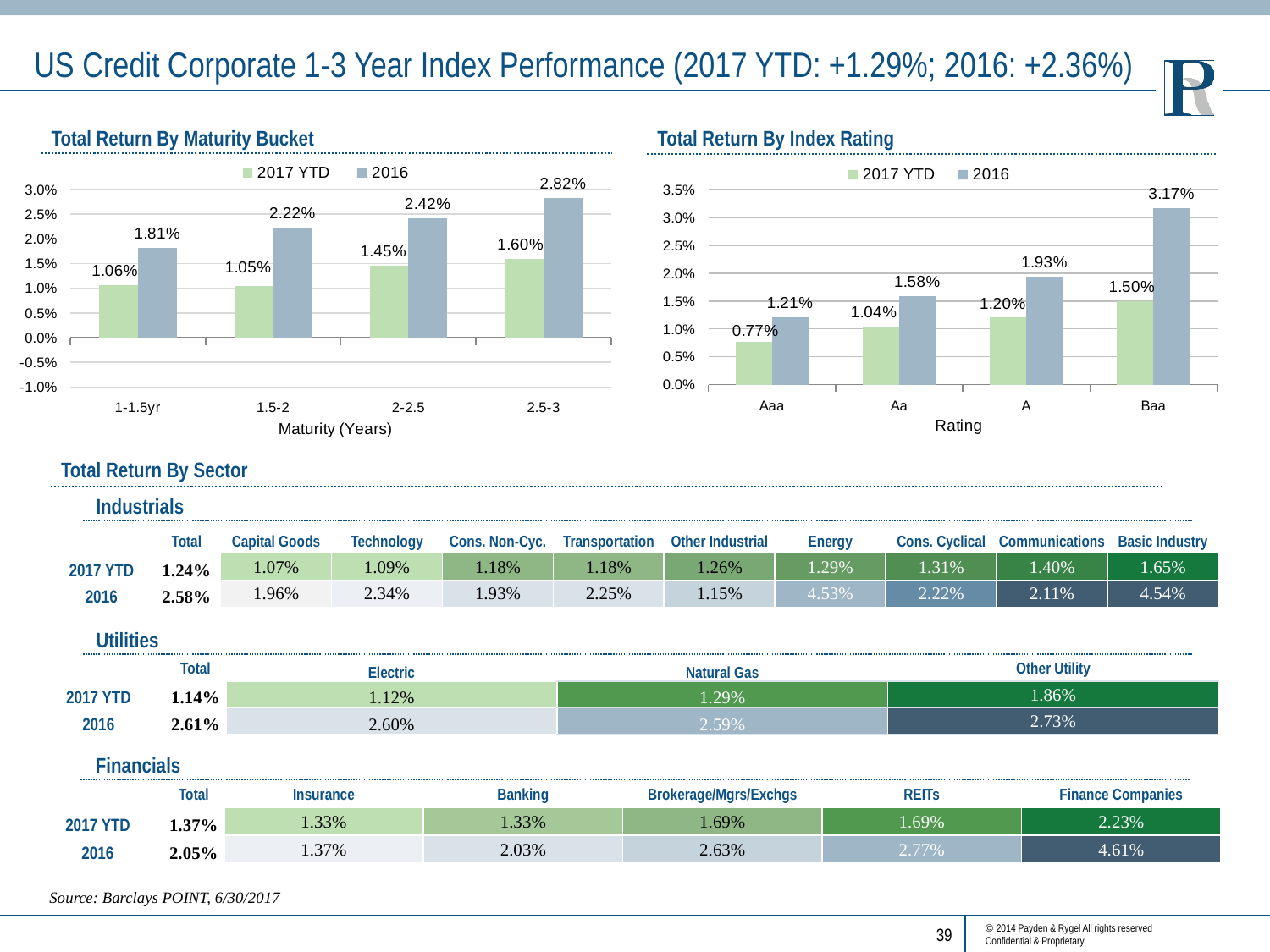
In the Total Return By Index Rating chart, what is the 2016 value for the Baa rating? 3.17% In the Total Return By Maturity Bucket chart, what is the 2017 YTD value for the 2-2.5 maturity bucket? 1.45% In the Total Return By Maturity Bucket chart, what is the 2016 value for the 2.5-3 maturity bucket? 2.82% In the Total Return By Maturity Bucket chart, do the 2016 values rise or fall as maturity increases? rise In the Total Return By Maturity Bucket chart, which maturity bucket has the lowest 2017 YTD value? 1.5-2 In the Total Return By Index Rating chart, which is larger: the 2016 value for A or the 2016 value for Aa? A What type of chart is the Total Return By Index Rating chart? bar chart In the Total Return By Index Rating chart, which rating has the highest 2017 YTD value? Baa In the Total Return By Maturity Bucket chart, what is the difference between the 2016 and 2017 YTD values for the 1-1.5yr bucket? 0.75% In the Total Return By Maturity Bucket chart, how many maturity buckets are shown on the x axis? 4 In the Total Return By Index Rating chart, how many series does the legend list? 2 In the Total Return By Index Rating chart, what is the 2017 YTD value for the Aaa rating? 0.77%